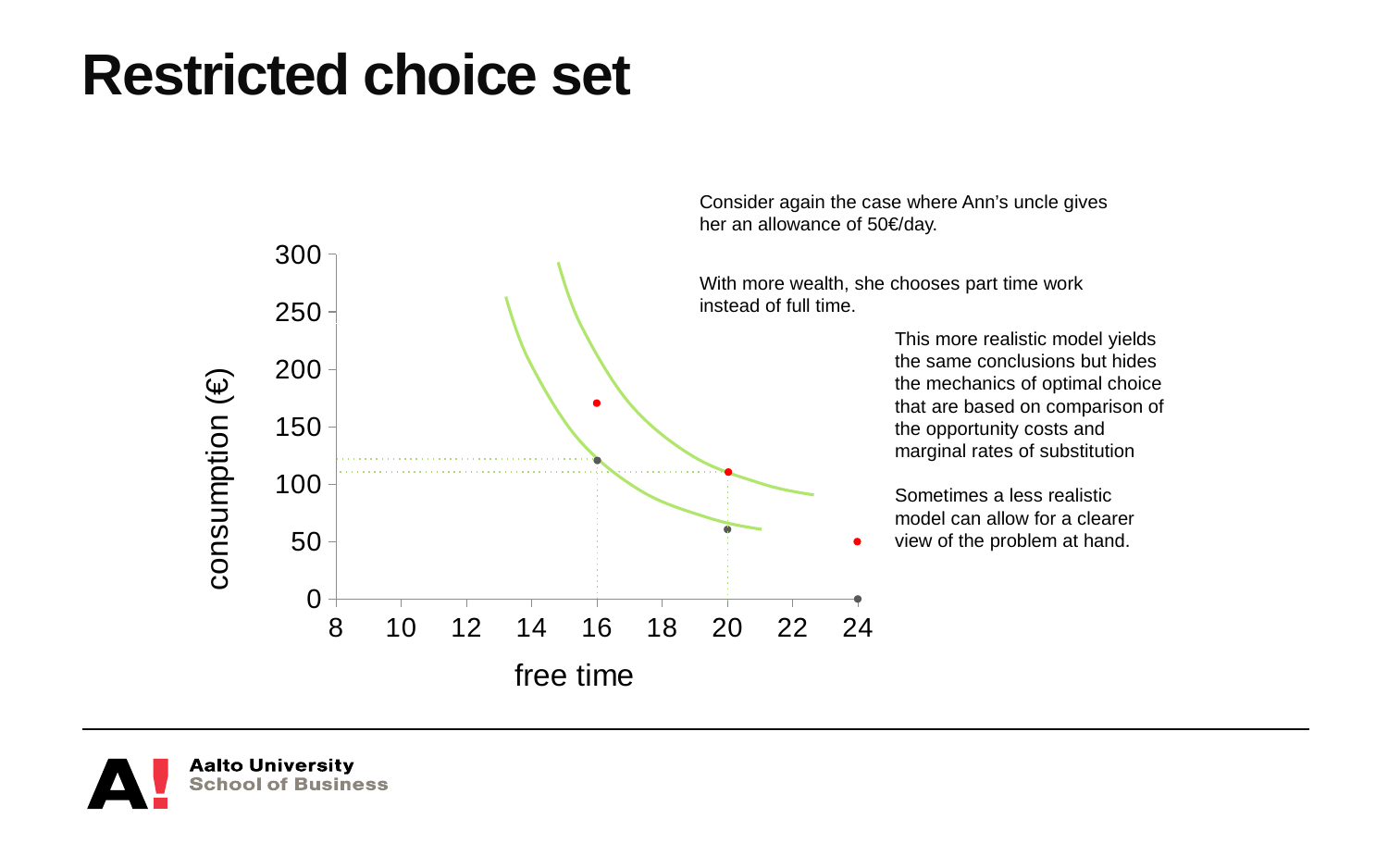
Is the consumption value of the grey point at free time 20 greater or less than 100? less What is the label of the y axis? consumption (€) Is the consumption value of the grey point at free time 16 greater or less than 100? greater Do the green curves rise or fall as free time increases? fall What is the consumption value of the red point at free time 24? 50 Is the consumption value of the red point at free time 16 greater or less than 150? greater Which point has the higher consumption value: the red point at free time 16 or the red point at free time 20? the red point at free time 16 What is the highest value shown on the y axis? 300 How many green curves are drawn on the chart? 2 What is the consumption value of the grey point at free time 24? 0 How many dots (points) are plotted on the chart? 6 What is the label of the x axis? free time